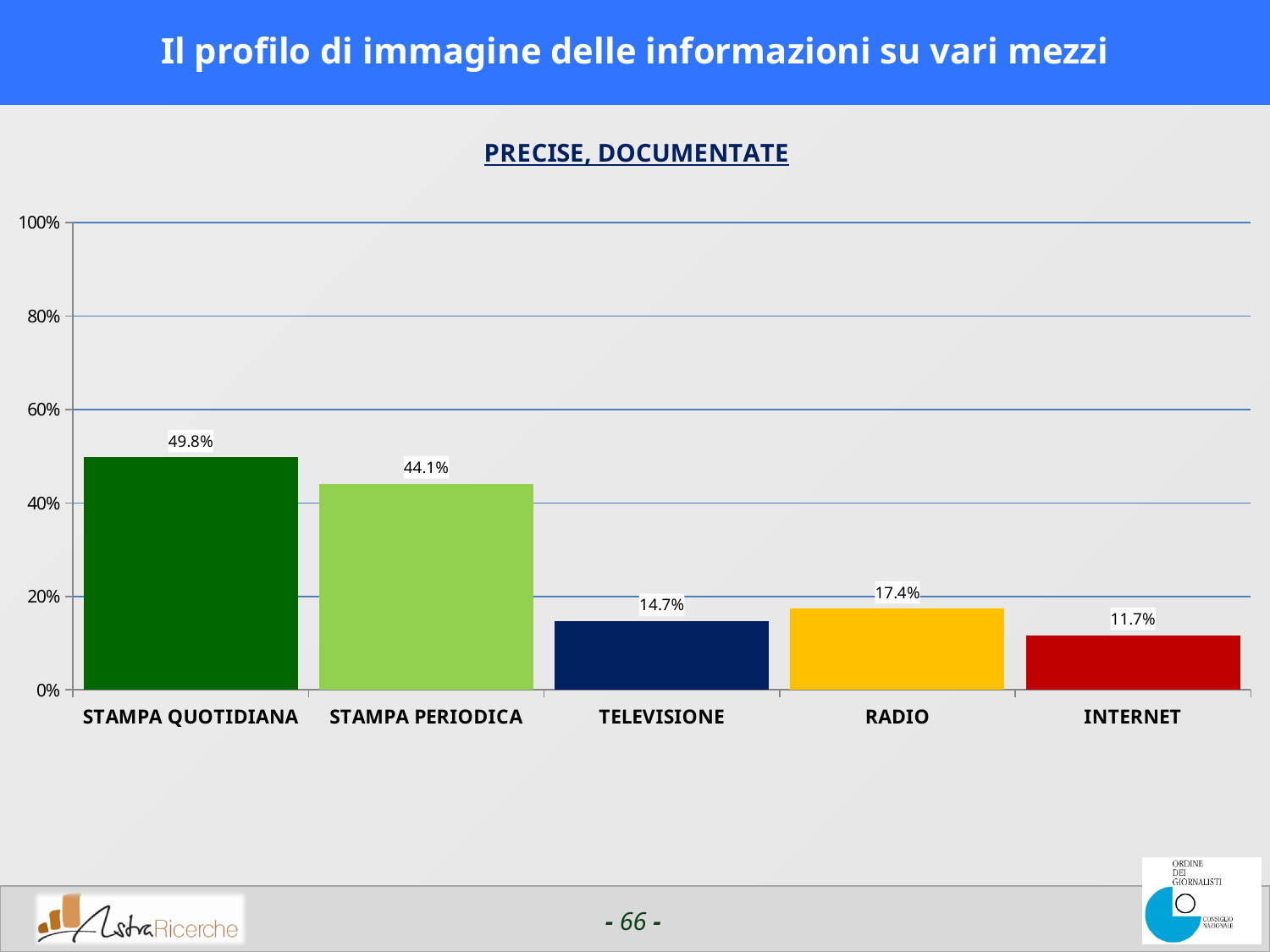
How many categories are shown on the x axis? 5 What is the value for STAMPA QUOTIDIANA? 49.8% What is the difference between the values for STAMPA QUOTIDIANA and STAMPA PERIODICA? 5.7% What is the value for RADIO? 17.4% What kind of chart is shown on the slide? bar chart What is the title shown above the chart? PRECISE, DOCUMENTATE Which is larger, the value for TELEVISIONE or the value for RADIO? RADIO What is the value for INTERNET? 11.7% Is the value for STAMPA PERIODICA greater or less than 40%? greater What is the difference between the values for RADIO and TELEVISIONE? 2.7% Which category has the highest value? STAMPA QUOTIDIANA Which category has the lowest value? INTERNET